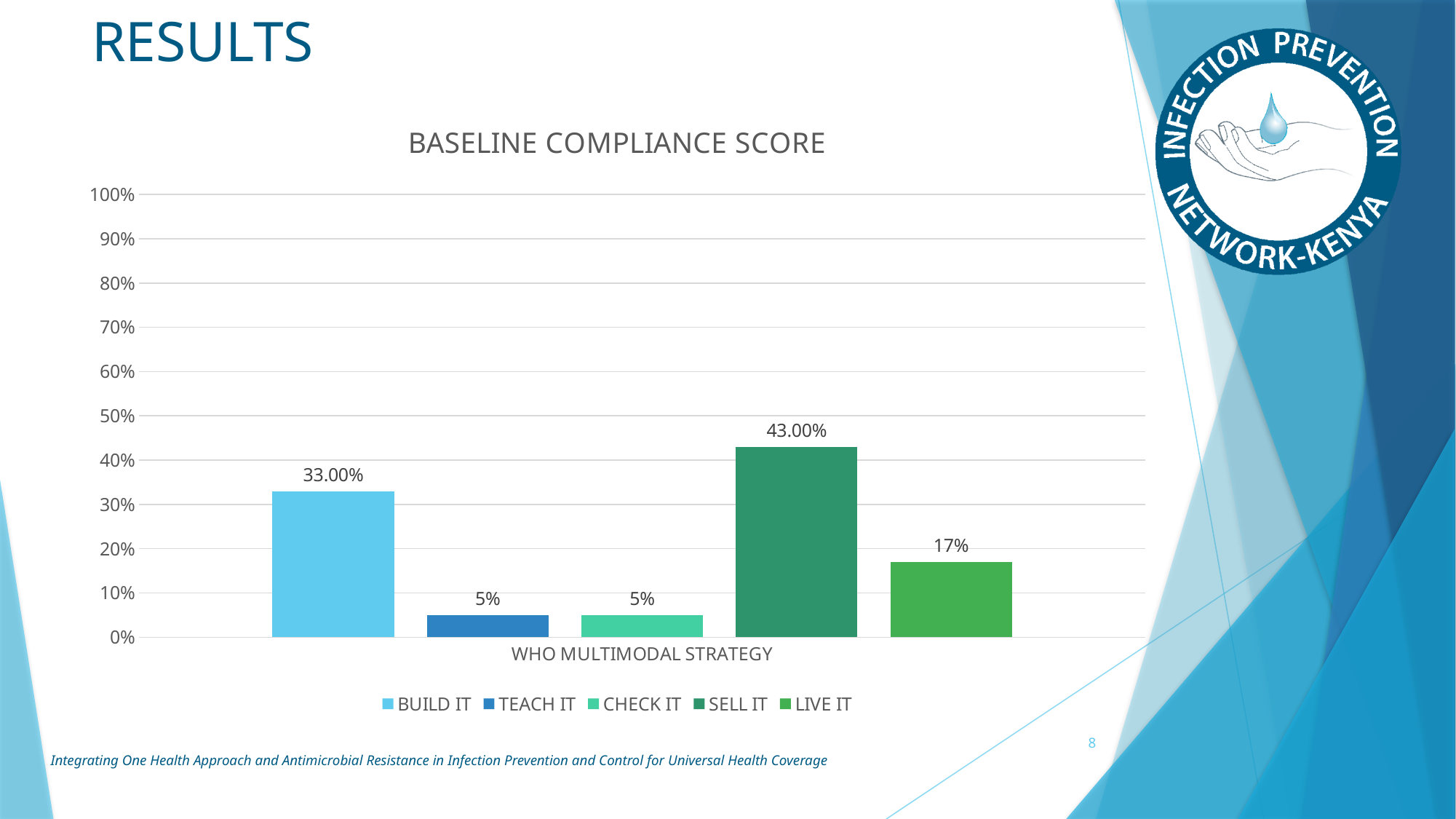
What is the title of the chart? BASELINE COMPLIANCE SCORE What is the baseline compliance score for LIVE IT? 17% Is the value for SELL IT greater or less than 40%? greater What is the baseline compliance score for BUILD IT? 33.00% Which series has the highest baseline compliance score? SELL IT What is the difference between the SELL IT and BUILD IT baseline compliance scores? 10.00% What kind of chart is shown on the slide? Bar chart What is the baseline compliance score for SELL IT? 43.00% What is the label on the x axis of the chart? WHO MULTIMODAL STRATEGY What is the baseline compliance score for TEACH IT? 5% How many series does the legend list? 5 Which has a higher baseline compliance score, BUILD IT or LIVE IT? BUILD IT